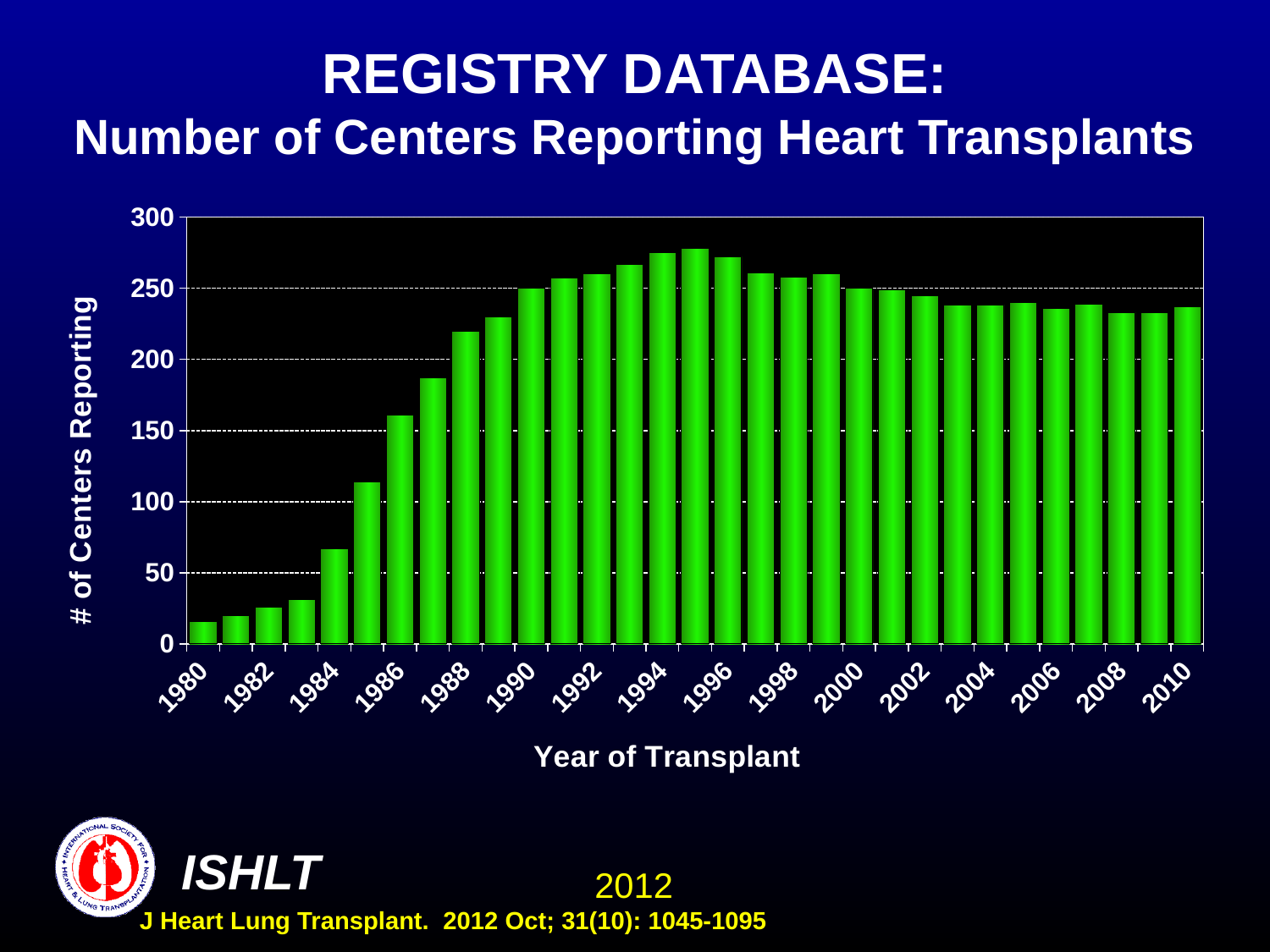
Do the values rise or fall from 1980 to 1990? rise What is the title of the horizontal axis? Year of Transplant What is the title of the vertical axis? # of Centers Reporting Is the value for 1985 greater or less than 50? greater Is the value for 1987 greater or less than 200? less Is the value for 1988 greater or less than 200? greater Which year has the lowest number of centers reporting? 1980 Which year has the larger number of centers reporting, 1988 or 2008? 2008 Which year has the larger number of centers reporting, 1985 or 1986? 1986 What kind of chart is shown on the slide? bar chart